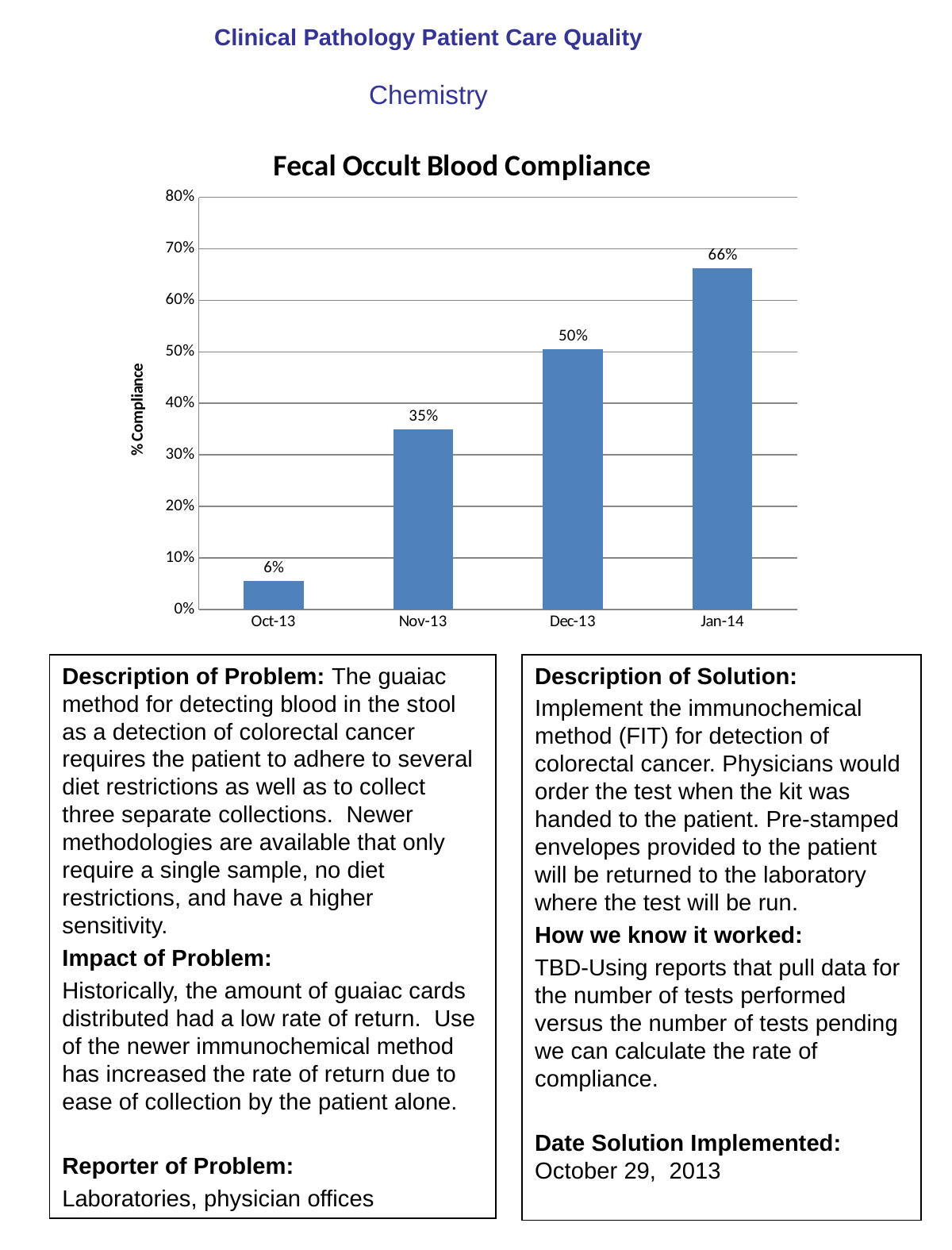
What is the compliance value for Jan-14? 66% Do the compliance values rise or fall from Oct-13 to Jan-14? Rise How many months are shown on the chart? 4 What kind of chart is shown? Bar chart Which has a higher compliance value, Nov-13 or Dec-13? Dec-13 What is the difference in compliance between Jan-14 and Oct-13? 60% What is the compliance value for Oct-13? 6% Which month has the highest compliance? Jan-14 What is the compliance value for Nov-13? 35% What is the compliance value for Dec-13? 50% Is the value for Jan-14 greater or less than 60%? greater Which month has the lowest compliance? Oct-13